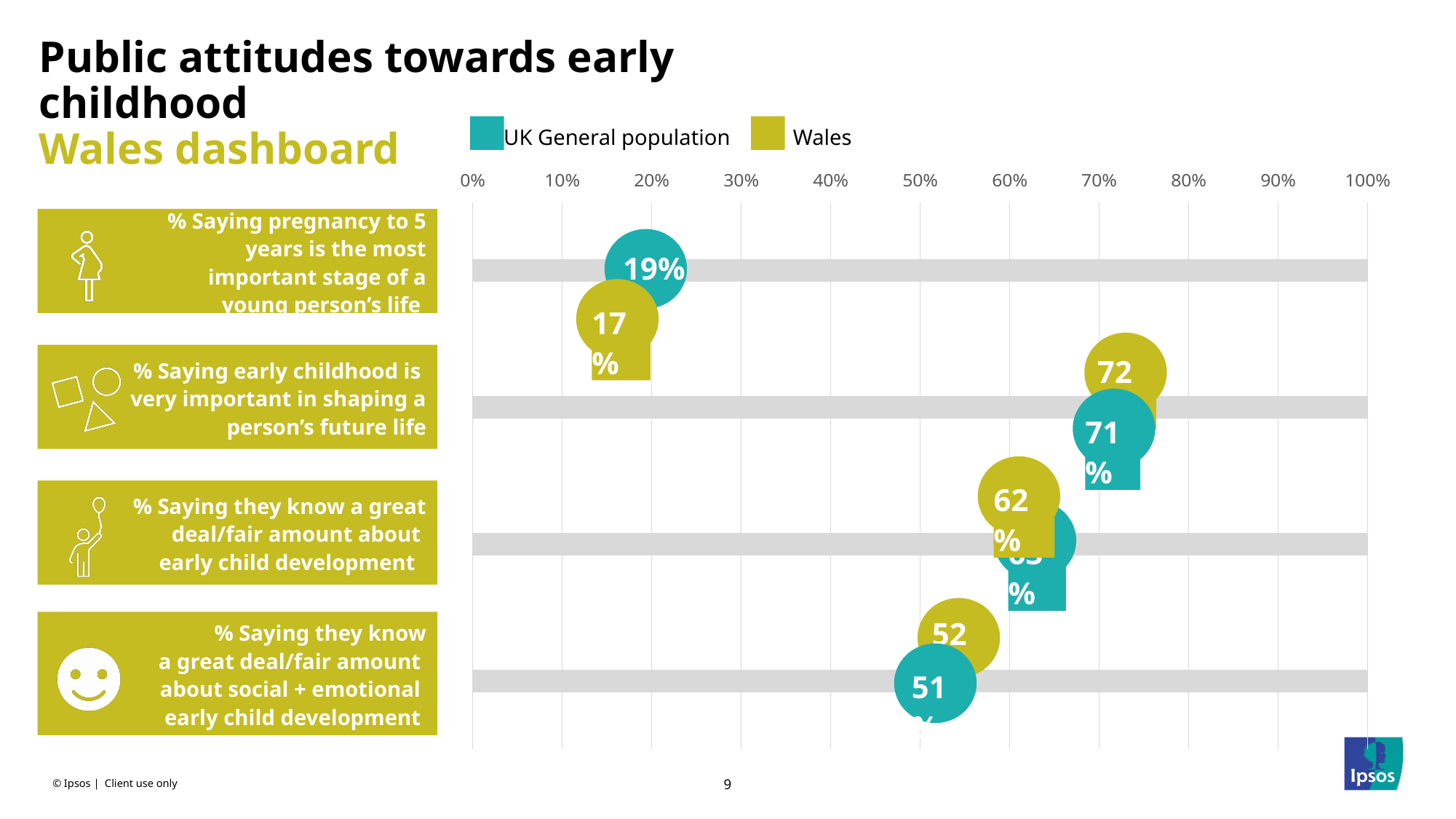
What is the value for Wales for '% Saying they know a great deal/fair amount about early child development'? 62% What is the value for Wales for '% Saying early childhood is very important in shaping a person's future life'? 72% What is the value for UK General population for '% Saying early childhood is very important in shaping a person's future life'? 71% Which colour represents Wales in the legend? Yellow-green What is the value for UK General population for '% Saying pregnancy to 5 years is the most important stage of a young person's life'? 19% How many statements (categories) are plotted on the chart? 4 What is the value for Wales for '% Saying they know a great deal/fair amount about social + emotional early child development'? 52% What is the value for Wales for '% Saying pregnancy to 5 years is the most important stage of a young person's life'? 17% Which statement has the lowest value for UK General population? % Saying pregnancy to 5 years is the most important stage of a young person's life What is the difference between the UK General population and Wales values for '% Saying pregnancy to 5 years is the most important stage of a young person's life'? 2 percentage points How many series does the legend list? 2 Which statement has the highest value for Wales? % Saying early childhood is very important in shaping a person's future life